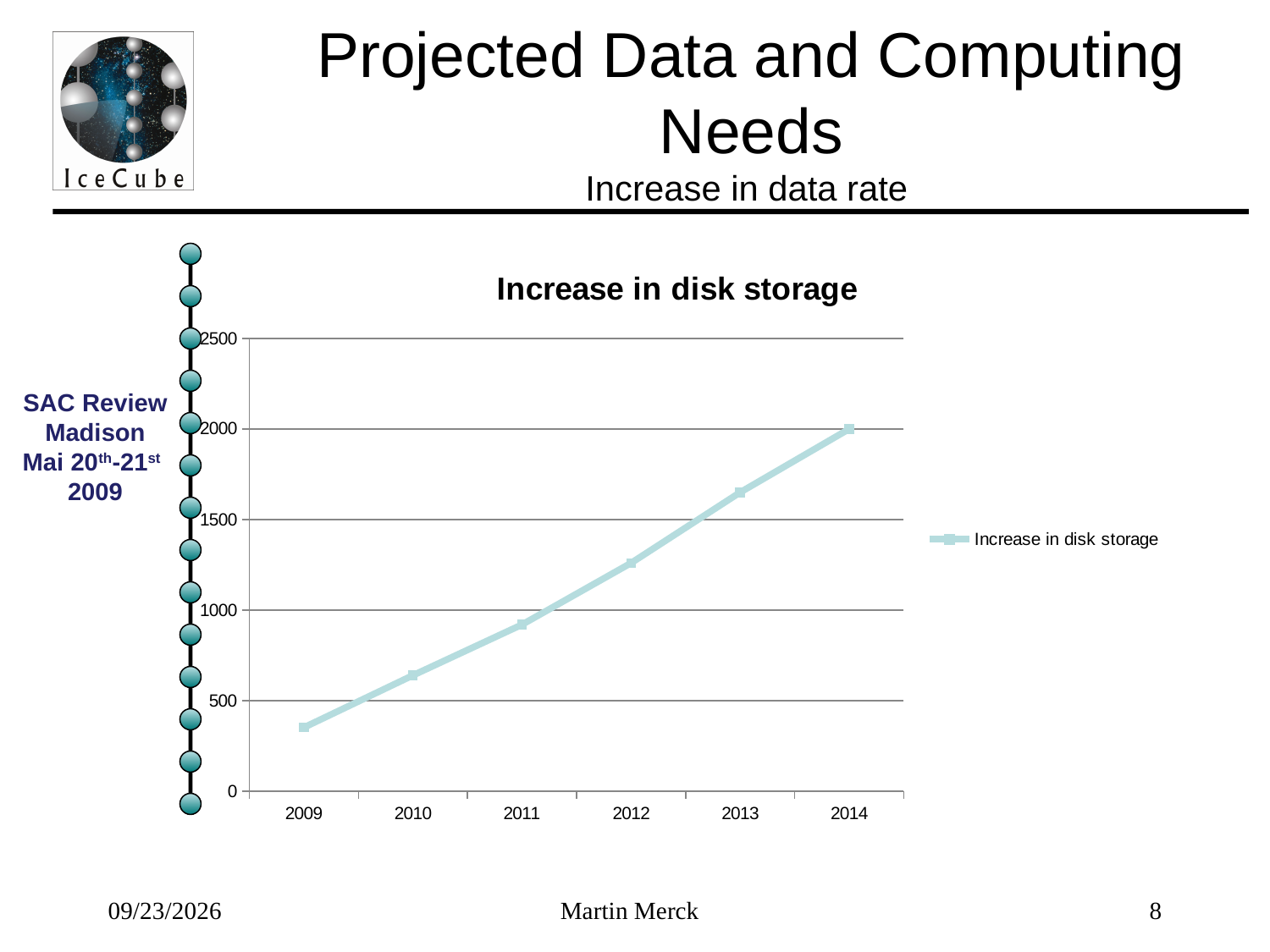
Which is larger, the value for 2012 or the value for 2013? 2013 Is the value for 2010 greater or less than 500? greater Is the value for 2013 greater or less than 1500? greater Is the value for 2009 greater or less than 500? less What is the title of the chart? Increase in disk storage Which year has the lowest value for Increase in disk storage? 2009 Do the values rise or fall from 2009 to 2014? rise What kind of chart is shown on the slide? line chart Which year has the highest value for Increase in disk storage? 2014 How many series does the legend list? 1 How many years are plotted on the x axis? 6